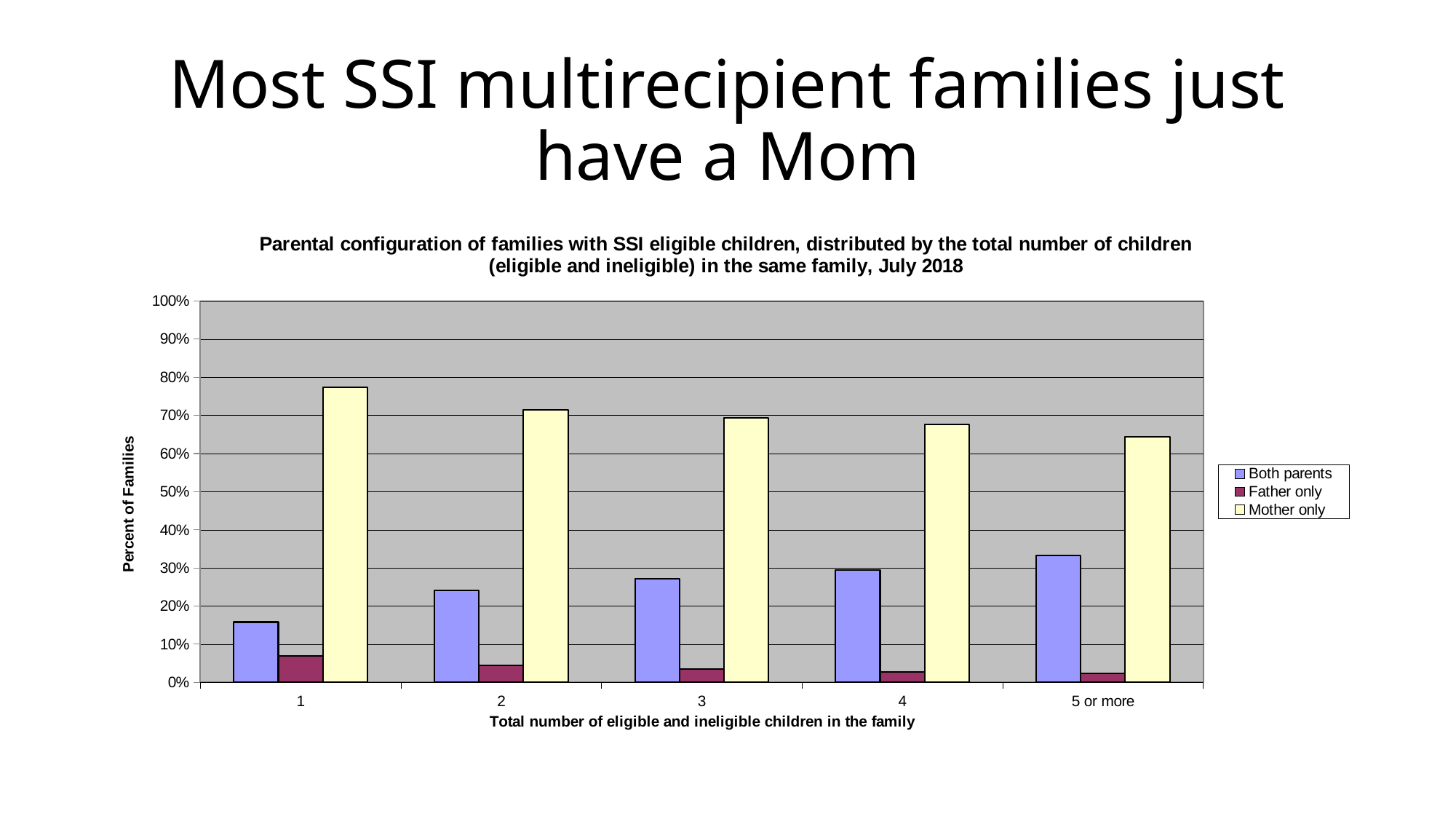
For which category is the Mother only value highest? 1 Is the Father only value for families with 3 children greater or less than 10%? less How many categories are shown on the x axis? 5 For which category is the Both parents value lowest? 1 Does the Mother only series rise or fall as the number of children increases? fall Which series has the highest value in every category? Mother only How many series does the legend list? 3 Which series has the lowest value in every category? Father only Is the Both parents value for families with 5 or more children greater or less than 30%? greater Is the Mother only value for families with 1 child greater or less than 70%? greater What kind of chart is shown on the slide? bar chart Which is larger: the Both parents value for 2 children or the Both parents value for 4 children? 4 children